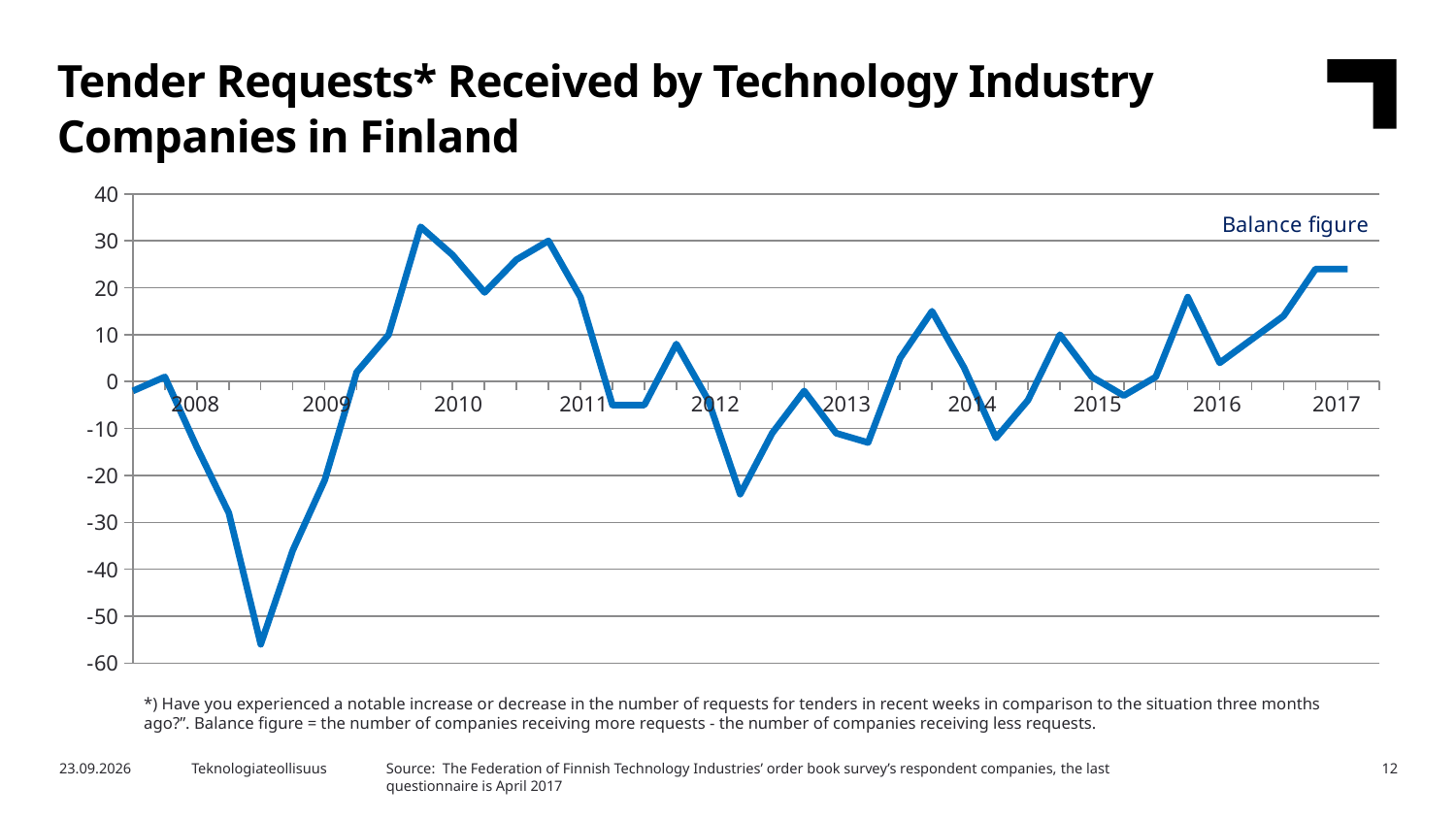
Is the value at the 2010 label greater or less than 20? greater Is the value at the end of the line (2017) greater or less than 20? greater Is the highest point of the line greater or less than 30? greater How many year labels are shown on the x axis? 10 Does the line rise or fall between the 2016 and 2017 labels? rises Does the line rise or fall between the 2008 and 2009 labels? falls What kind of chart is shown on the slide? line chart What is the highest value shown on the y axis? 40